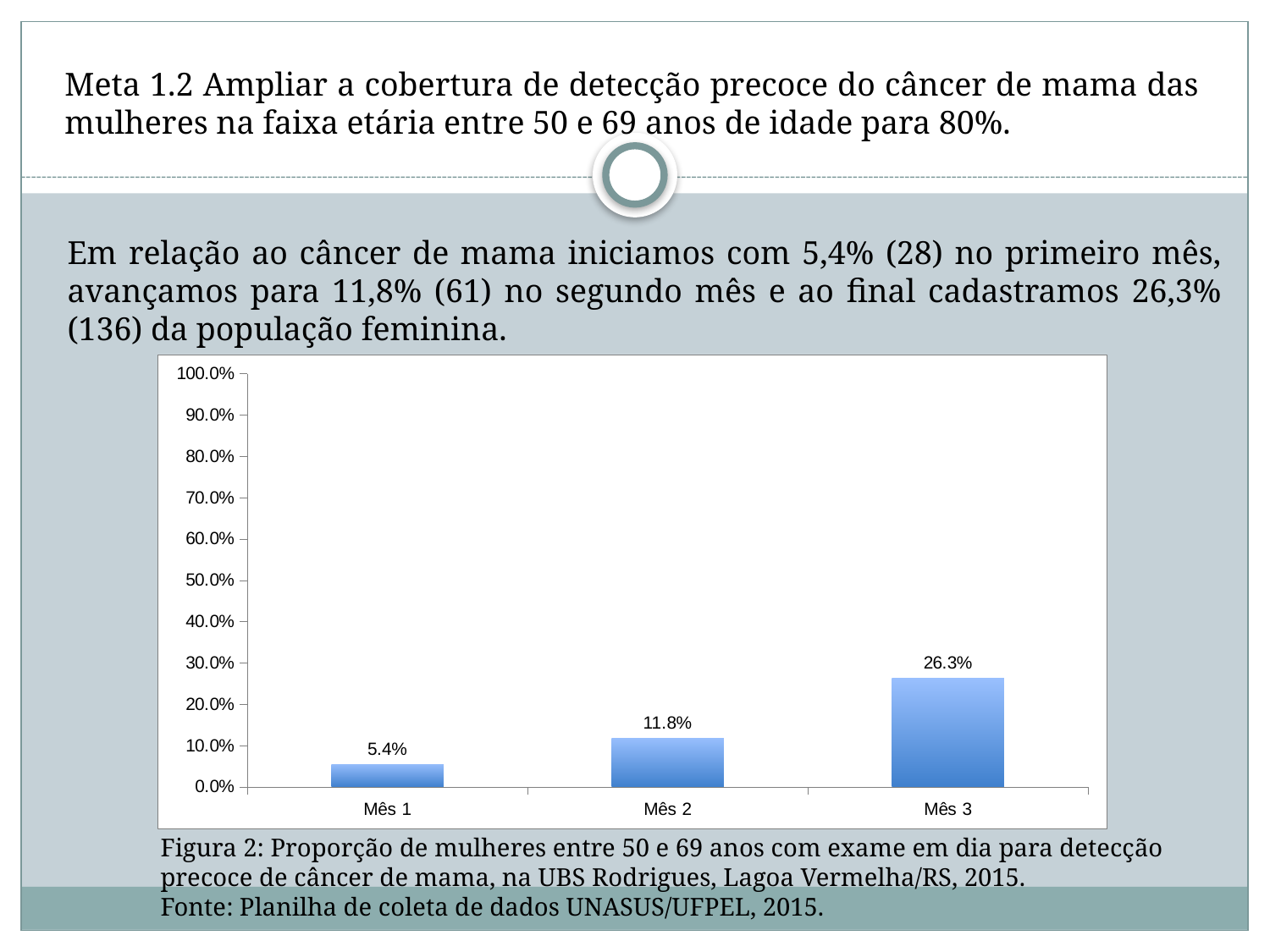
What is the difference between the values for Mês 3 and Mês 1? 20.9% What is the value for Mês 1? 5.4% What is the difference between the values for Mês 2 and Mês 1? 6.4% Which month has the highest value? Mês 3 Which month has the lowest value? Mês 1 Which is larger, the value for Mês 2 or the value for Mês 3? Mês 3 What is the value for Mês 2? 11.8% What kind of chart is shown on the slide? bar chart Do the values rise or fall from Mês 1 to Mês 3? rise How many months are shown on the x axis? 3 Is the value for Mês 3 greater or less than 30.0%? less What is the value for Mês 3? 26.3%